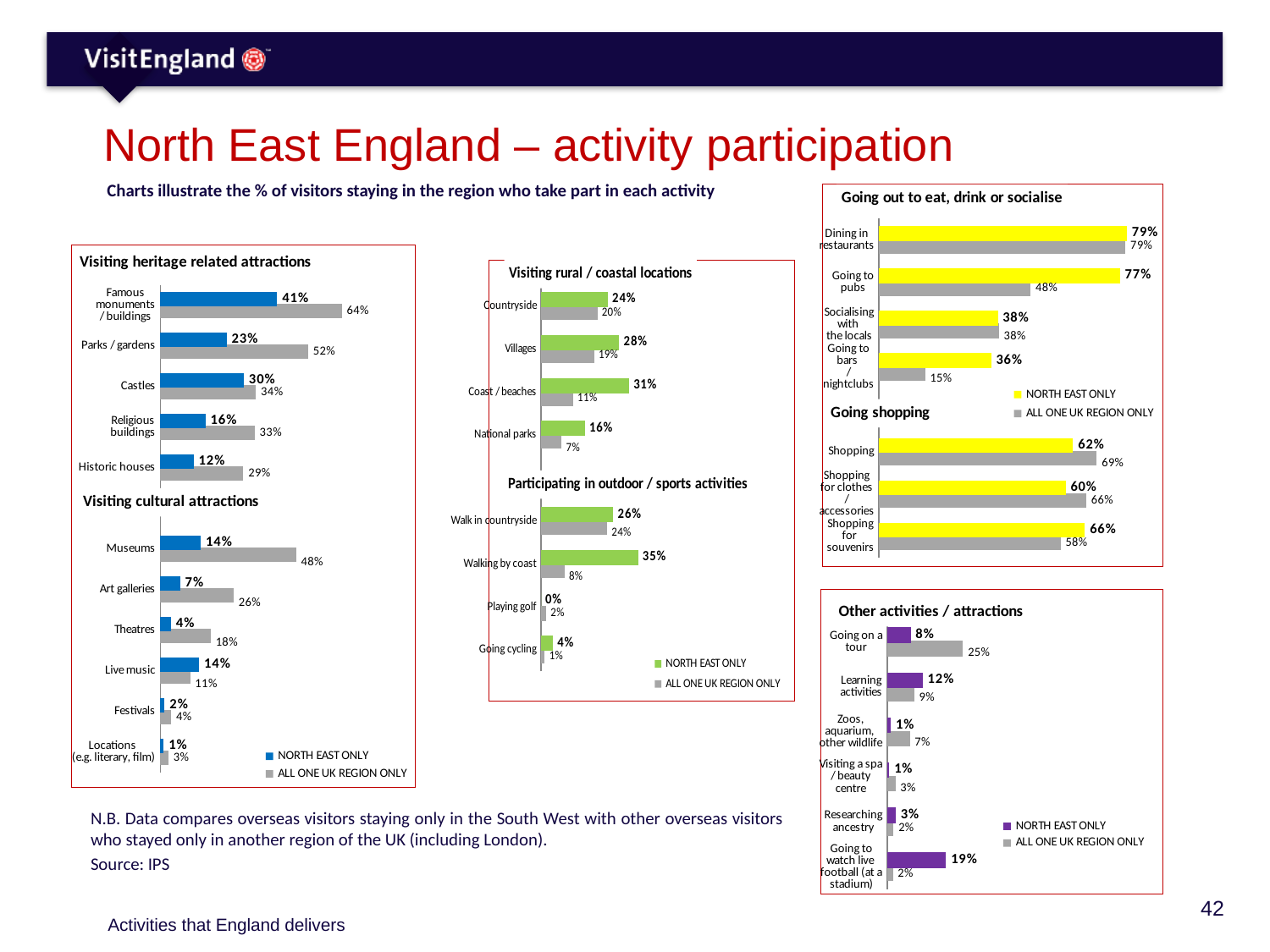
In the 'Visiting cultural attractions' chart, what is the difference between the ALL ONE UK REGION ONLY and NORTH EAST ONLY values for Museums? 34% In the 'Going shopping' chart, what is the ALL ONE UK REGION ONLY value for Shopping? 69% In the 'Participating in outdoor / sports activities' chart, which category has the lowest NORTH EAST ONLY value? Playing golf How many categories are shown in the 'Other activities / attractions' chart? 6 In the 'Other activities / attractions' chart, what is the NORTH EAST ONLY value for Going to watch live football (at a stadium)? 19% In the 'Visiting heritage related attractions' chart, what is the NORTH EAST ONLY value for Famous monuments / buildings? 41% In the 'Participating in outdoor / sports activities' chart, what is the NORTH EAST ONLY value for Walking by coast? 35% How many series does the legend list in the 'Visiting heritage related attractions' chart? 2 In the 'Going out to eat, drink or socialise' chart, which is larger for Going to pubs: NORTH EAST ONLY or ALL ONE UK REGION ONLY? NORTH EAST ONLY In the 'Visiting rural / coastal locations' chart, which category has the highest NORTH EAST ONLY value? Coast / beaches In the 'Visiting heritage related attractions' chart, what is the ALL ONE UK REGION ONLY value for Parks / gardens? 52%